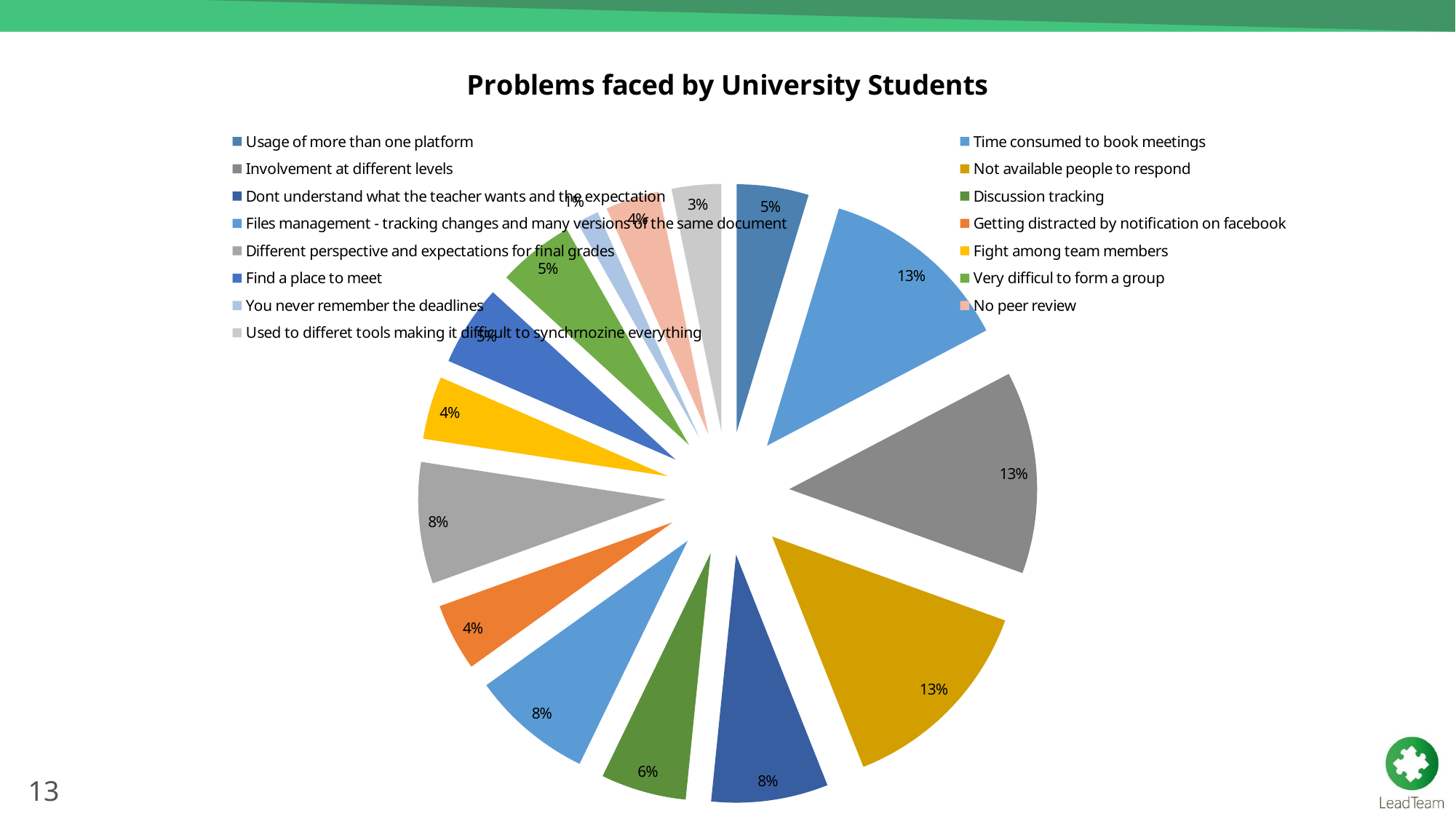
Which is larger, 'Not available people to respond' or 'Dont understand what the teacher wants and the expectation'? Not available people to respond Which category has the smallest share of the pie? You never remember the deadlines What is the difference in percentage points between 'Involvement at different levels' and 'Different perspective and expectations for final grades'? 5 What percentage is shown for 'Used to differet tools making it difficult to synchrnozine everything'? 3% What kind of chart is shown on the slide? pie chart What percentage is shown for 'Discussion tracking'? 6% What is the title of the chart? Problems faced by University Students What percentage is shown for 'Fight among team members'? 4% How many categories have a share of 13%? 3 What share of the pie is 'Time consumed to book meetings'? 13% What percentage is shown for 'Usage of more than one platform'? 5% How many categories does the pie chart have? 15